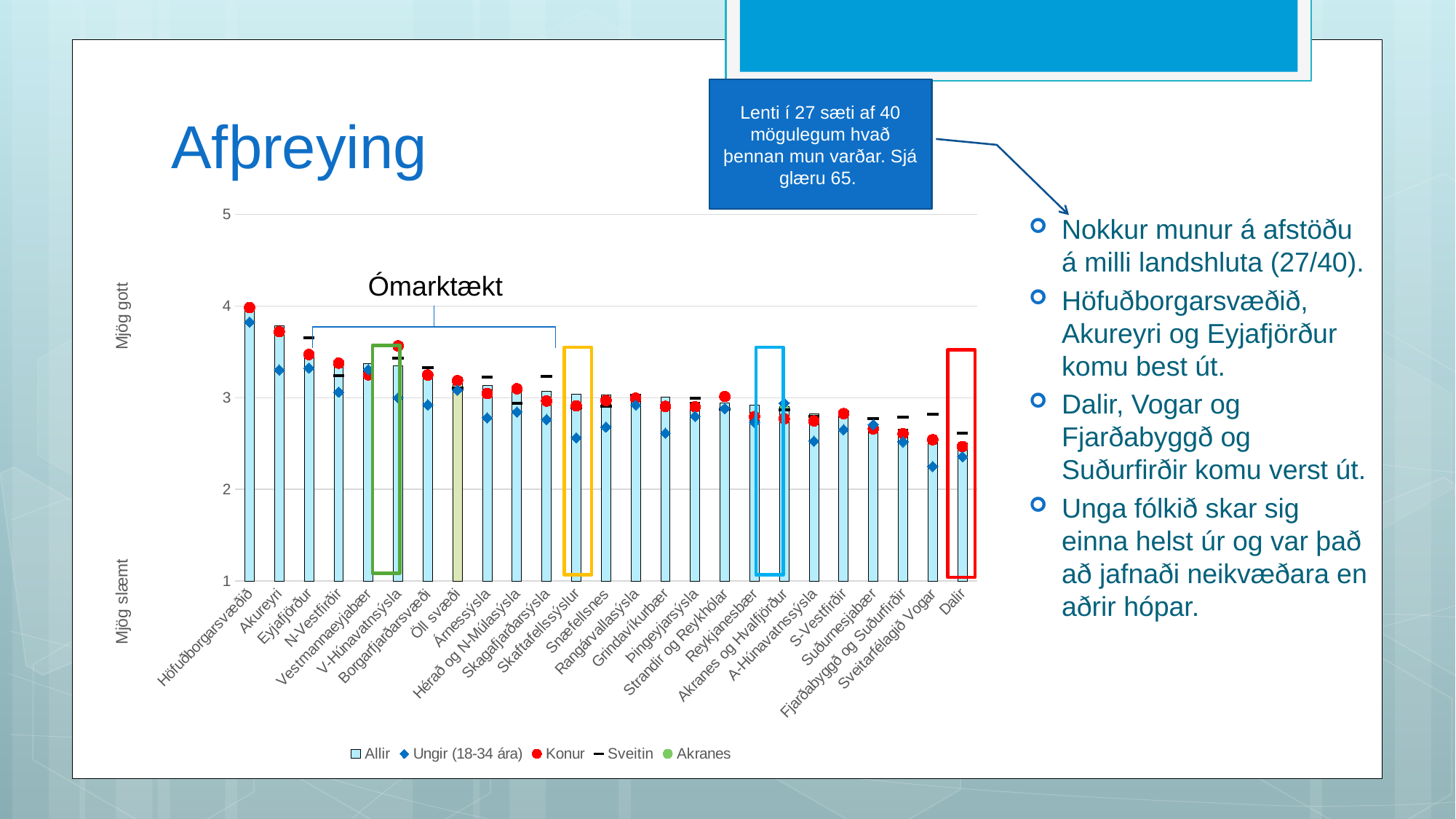
Do the Allir bar values generally rise or fall from left to right along the x axis? fall How many categories (regions) are shown along the x axis of the chart? 25 Which region has the lowest Allir bar in the chart? Dalir What is the title of the slide containing the chart? Afþreying Is the Allir value for Höfuðborgarsvæðið greater or less than 3? greater Is the Ungir (18-34 ára) value for Dalir greater or less than 3? less How many series does the chart legend list? 5 Is the Allir value for Dalir greater or less than 3? less Which series in the legend is shown with a red circle marker? Konur What kind of chart is shown on the slide? bar chart Which region has the highest Allir bar in the chart? Höfuðborgarsvæðið Which has the larger Allir value, Akureyri or Dalir? Akureyri